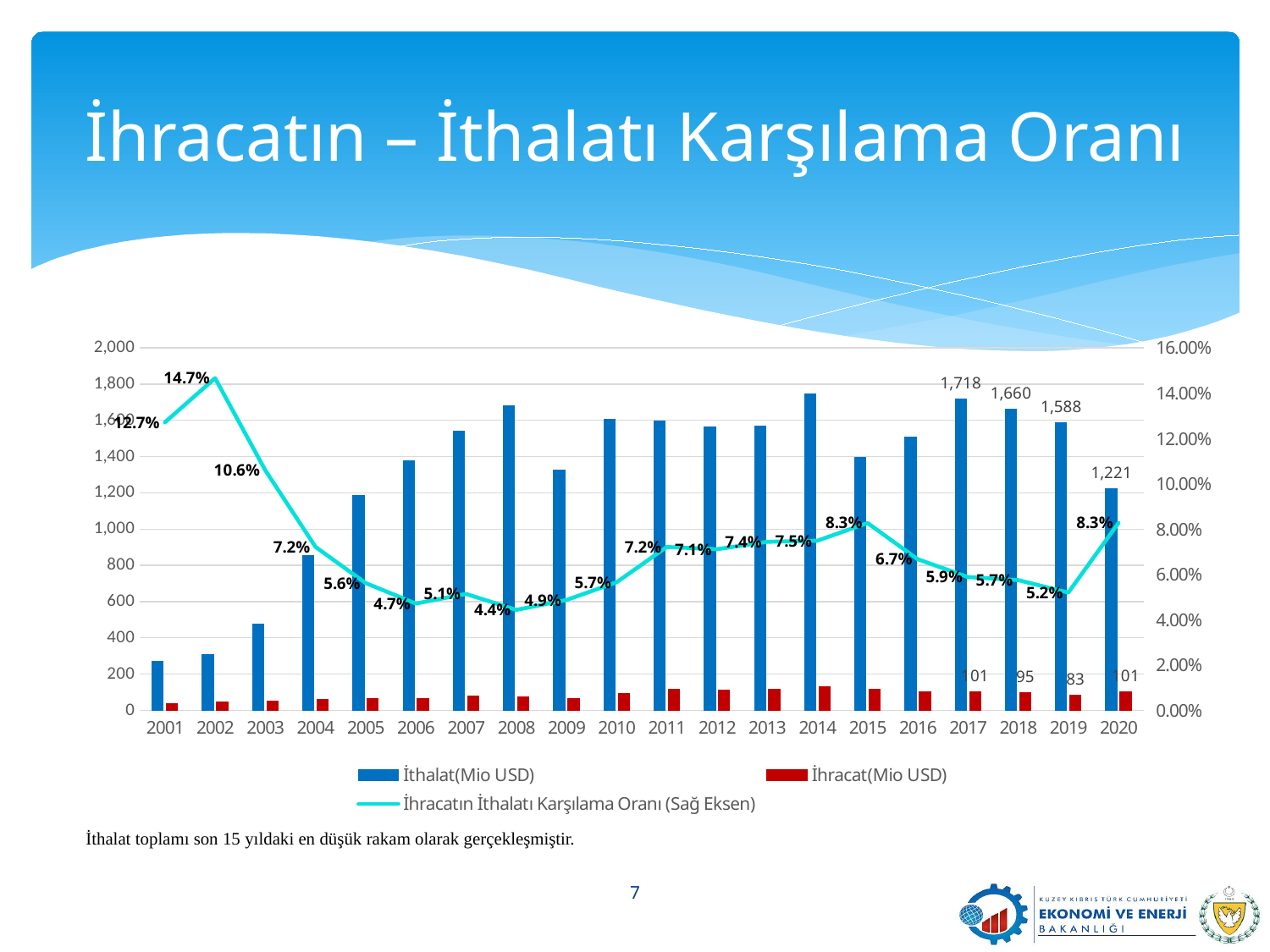
How many series does the legend list? 3 Which year has the larger İthalat value, 2019 or 2020? 2019 Is the İthalat value for 2001 greater or less than 400? less In which year is the İhracatın İthalatı Karşılama Oranı lowest? 2008 What is the İthalat (Mio USD) value for 2020? 1,221 What is the difference between the İthalat values for 2017 and 2018? 58 What is the İhracat (Mio USD) value for 2019? 83 How many years are shown on the x axis? 20 What is the İhracatın İthalatı Karşılama Oranı for 2002? 14.7% What is the difference between the İhracat values for 2018 and 2019? 12 What kind of chart is shown on the slide? Combination bar and line chart In which year is the İhracatın İthalatı Karşılama Oranı highest? 2002